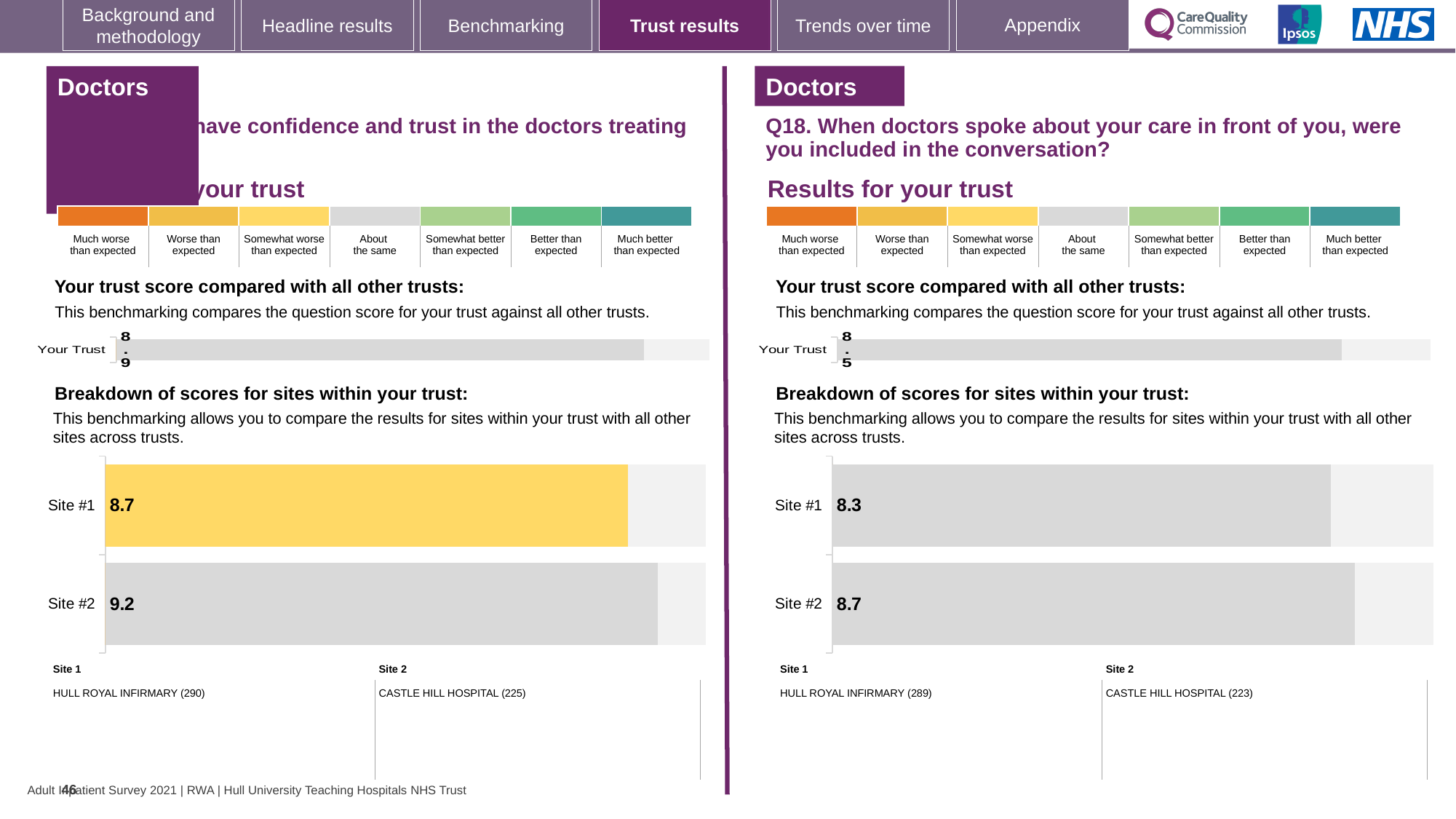
On the left-hand site breakdown chart, which site has the higher score? Site #2 On the right-hand Q18 site breakdown chart, which site has the lower score? Site #1 On the right-hand Q18 chart (breakdown of scores for sites within your trust), what is the score for Site #1? 8.3 On the left-hand site breakdown chart, what is the difference between the Site #2 and Site #1 scores? 0.5 On the right-hand Q18 'Your trust score compared with all other trusts' chart, what is the score for Your Trust? 8.5 On the left-hand chart (breakdown of scores for sites within your trust), what is the score for Site #1? 8.7 On the right-hand Q18 site breakdown chart, what is the difference between the Site #2 and Site #1 scores? 0.4 What type of chart is used for the site breakdown on the left-hand side of the slide? Bar chart On the left-hand chart (breakdown of scores for sites within your trust), what is the score for Site #2? 9.2 How many sites are shown in the right-hand Q18 site breakdown chart? 2 On the right-hand Q18 chart (breakdown of scores for sites within your trust), what is the score for Site #2? 8.7 On the left-hand 'Your trust score compared with all other trusts' chart, what is the score for Your Trust? 8.9